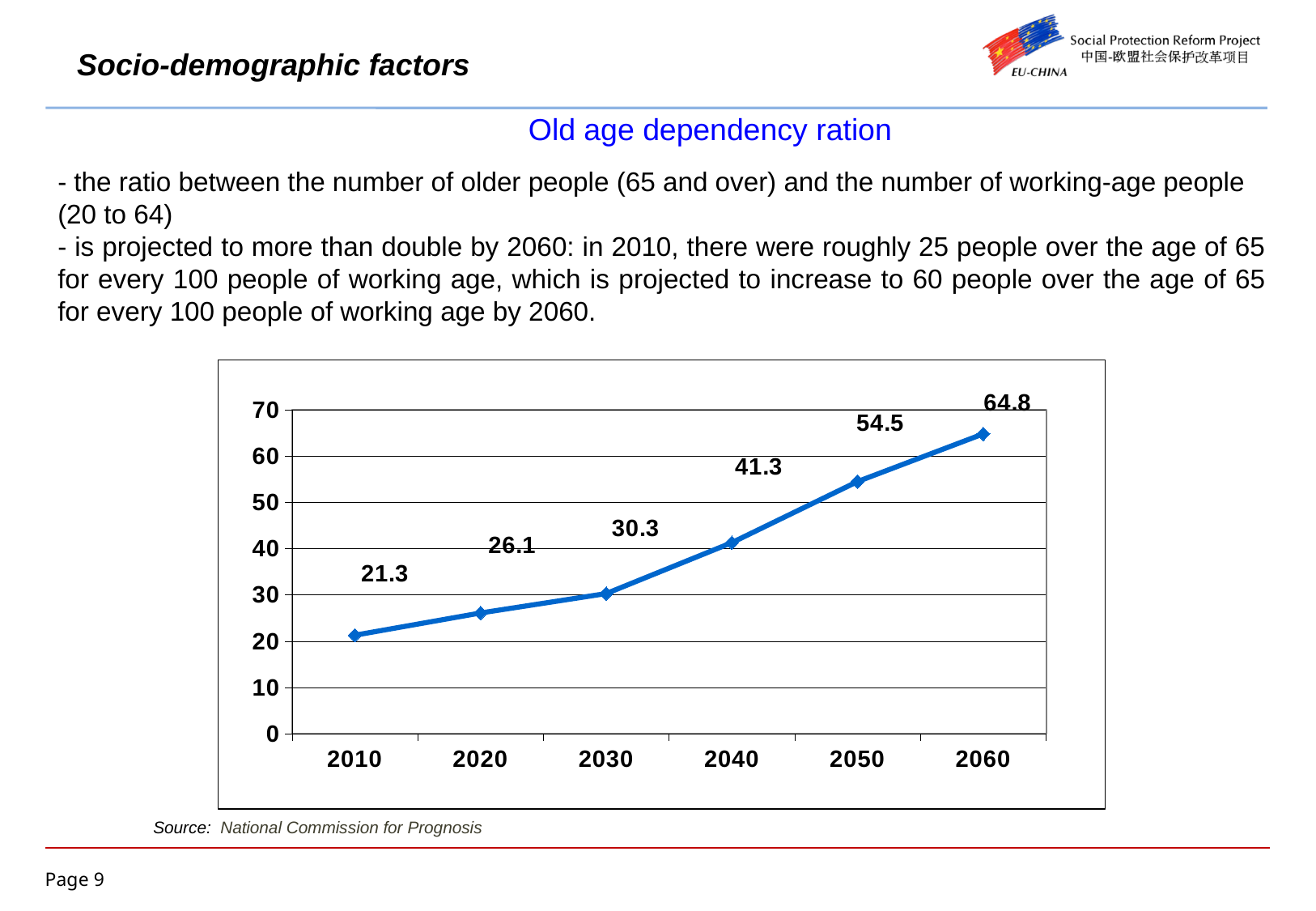
Do the values rise or fall from 2010 to 2060? rise What is the difference between the values for 2060 and 2010? 43.5 Is the value for 2050 greater or less than 50? greater What is the old age dependency ratio value plotted for 2010? 21.3 What value is shown for 2040 on the line chart? 41.3 Which year has the lowest value on the chart? 2010 How many data points are plotted on the line chart? 6 What value is shown for 2060 on the line chart? 64.8 Which year has the highest value on the chart? 2060 What is the difference between the values for 2050 and 2040? 13.2 Which is larger, the value for 2030 or the value for 2020? 2030 What kind of chart is shown on the slide? line chart